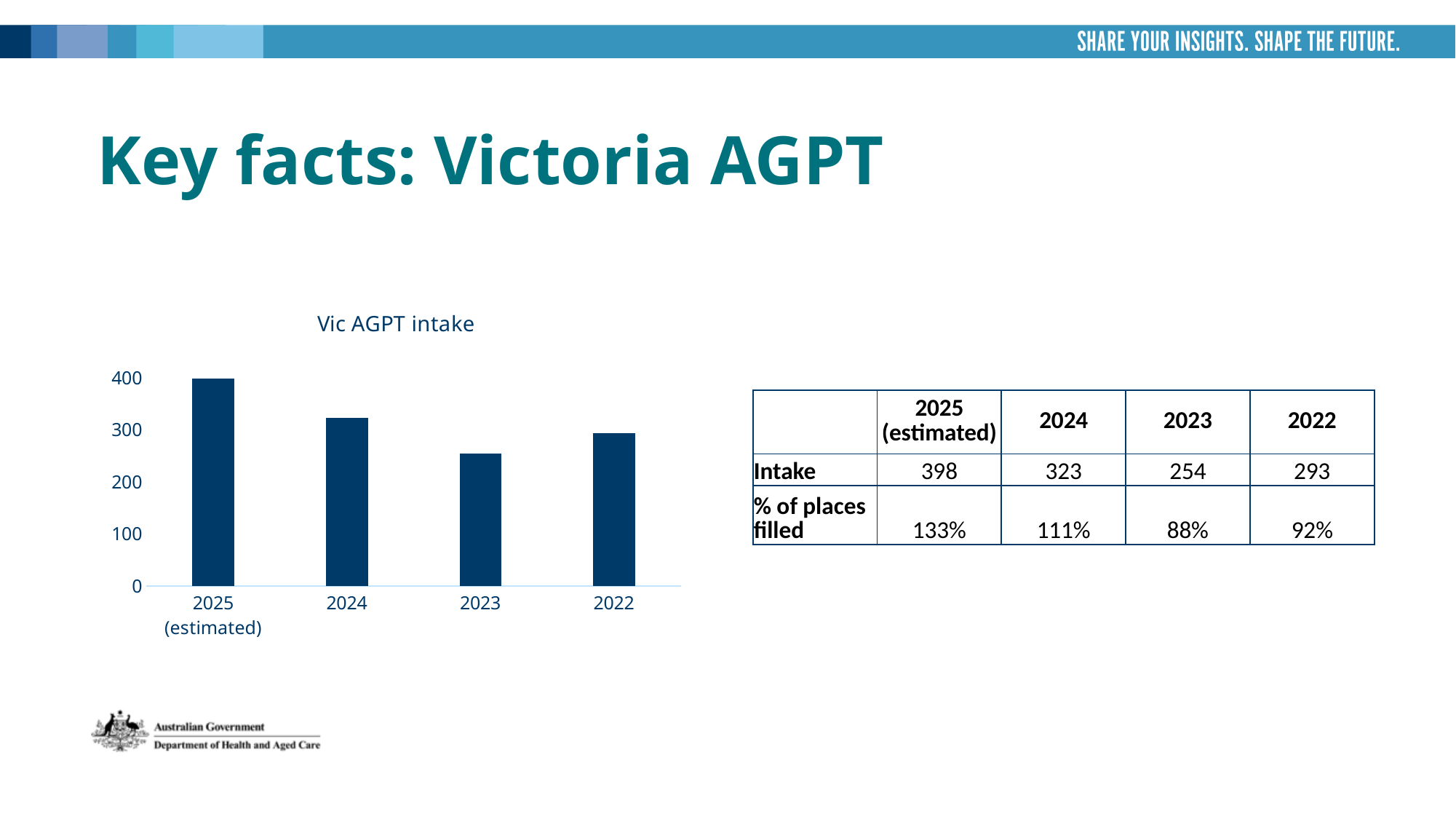
What is the Vic AGPT intake for 2022? 293 Is the Vic AGPT intake for 2023 greater or less than 300? less What is the title of the chart on the slide? Vic AGPT intake Which year has the highest intake in the "Vic AGPT intake" chart? 2025 (estimated) What is the difference between the Vic AGPT intake for 2025 (estimated) and for 2024? 75 Which is larger in the "Vic AGPT intake" chart, the intake for 2024 or for 2022? 2024 What is the Vic AGPT intake for 2023? 254 Which year has the lowest intake in the "Vic AGPT intake" chart? 2023 What is the Vic AGPT intake for 2025 (estimated)? 398 How many bars are shown in the "Vic AGPT intake" chart? 4 What type of chart is the "Vic AGPT intake" chart? bar chart Is the Vic AGPT intake for 2024 greater or less than 300? greater